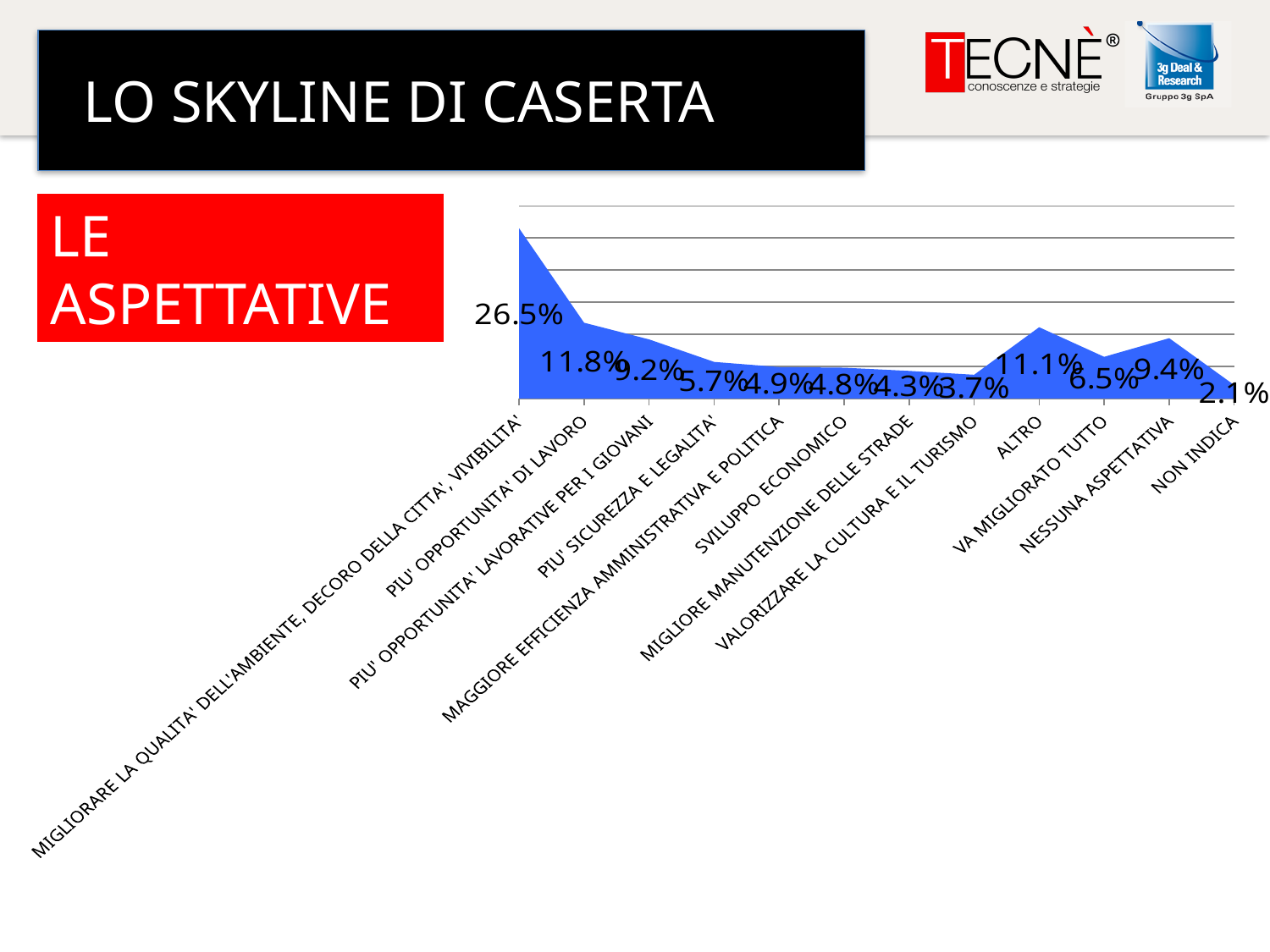
What is the value for PIU' SICUREZZA E LEGALITA'? 5.7% Which category has the lowest value? NON INDICA Which is larger, the value for ALTRO or the value for VA MIGLIORATO TUTTO? ALTRO What is the difference between the values for NESSUNA ASPETTATIVA and VA MIGLIORATO TUTTO? 2.9% How many categories are plotted on the chart? 12 What is the value for NON INDICA? 2.1% What is the difference between the values for MIGLIORARE LA QUALITA' DELL'AMBIENTE, DECORO DELLA CITTA', VIVIBILITA' and PIU' OPPORTUNITA' DI LAVORO? 14.7% Which category has the highest value? MIGLIORARE LA QUALITA' DELL'AMBIENTE, DECORO DELLA CITTA', VIVIBILITA' What kind of chart is shown on the slide? Area chart What is the value for NESSUNA ASPETTATIVA? 9.4% What is the value for PIU' OPPORTUNITA' DI LAVORO? 11.8% What is the value for ALTRO? 11.1%